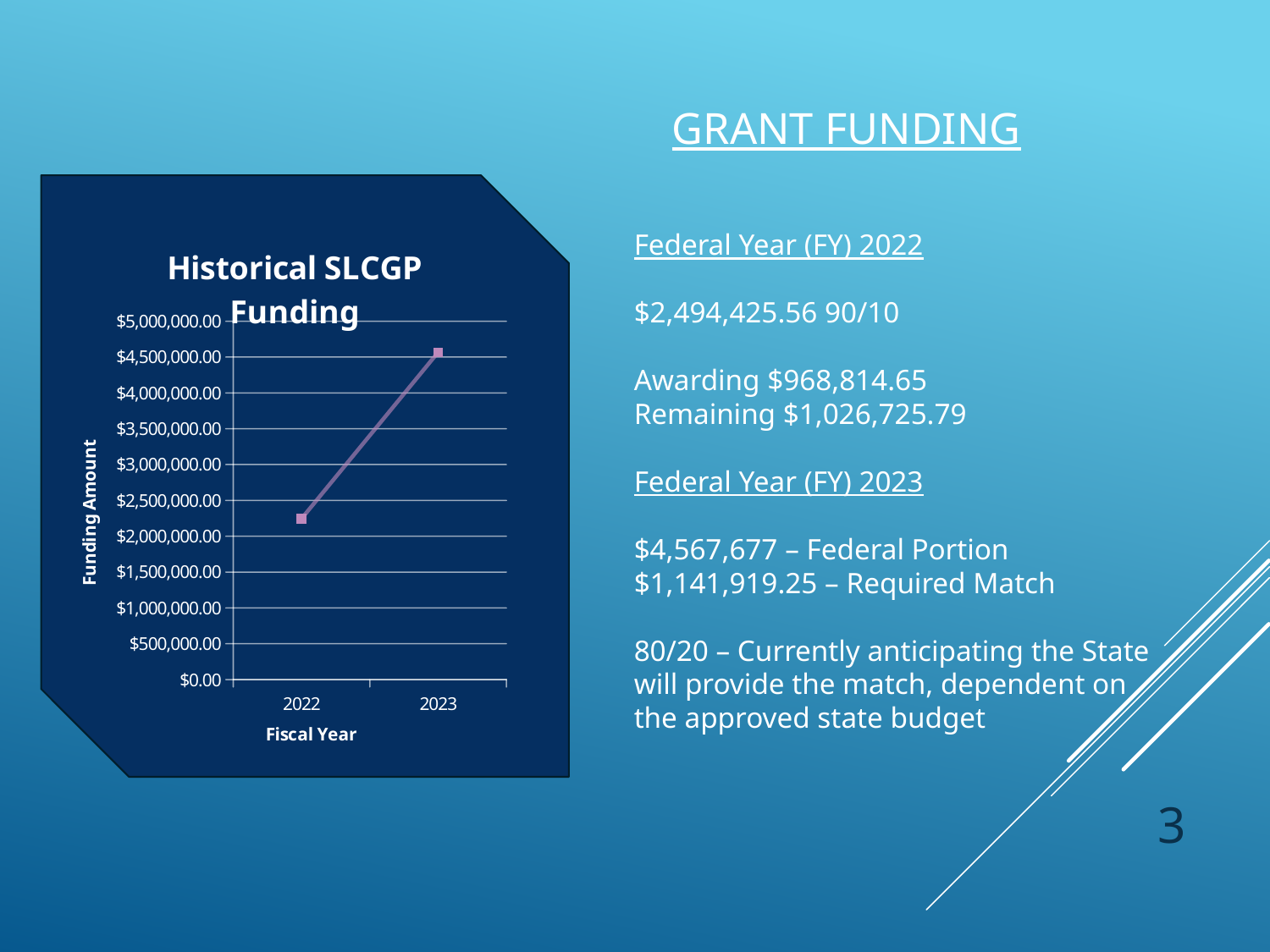
What kind of chart is shown on the slide? line chart How many fiscal years are plotted on the chart? 2 What is the title of the chart? Historical SLCGP Funding Which fiscal year has the highest funding amount on the chart? 2023 What is the label on the x axis of the chart? Fiscal Year Is the funding amount for 2023 greater or less than $5,000,000.00? less Does the funding amount rise or fall from 2022 to 2023? rise Is the funding amount for 2023 greater or less than $4,000,000.00? greater Which fiscal year has the lowest funding amount on the chart? 2022 Is the funding amount for 2022 greater or less than $2,000,000.00? greater Which fiscal year has the larger funding amount, 2022 or 2023? 2023